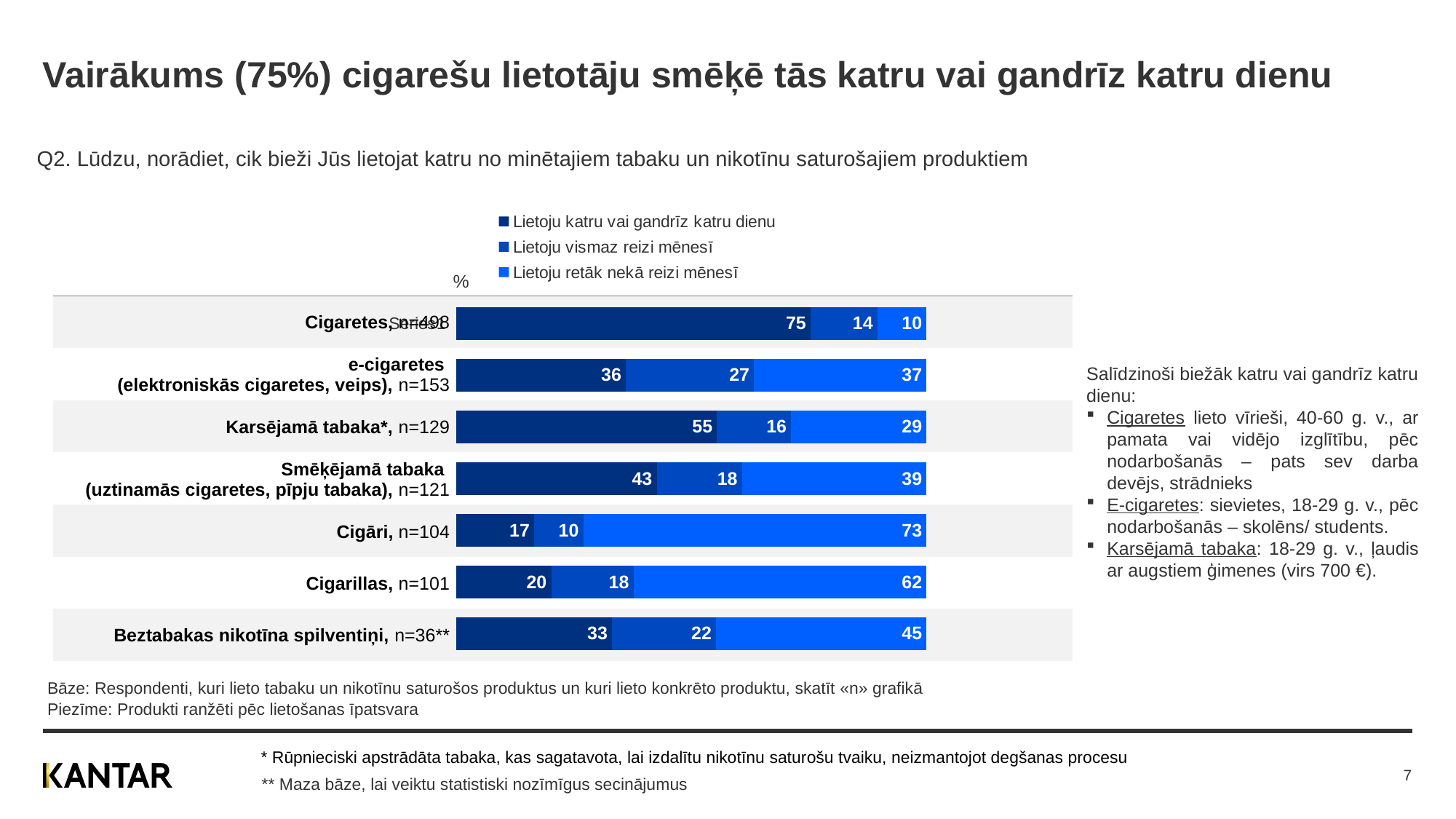
What is the total of the three segments for the Cigaretes bar? 99 What is the sample size (n) shown for Cigarillas? n=101 Which product has the highest share of users who use it every day or almost every day? Cigaretes What is the value for Cigāri in the 'Lietoju retāk nekā reizi mēnesī' series? 73 What is the difference between the daily-use values for Karsējamā tabaka and Smēķējamā tabaka? 12 Which is larger: the 'Lietoju retāk nekā reizi mēnesī' value for Cigarillas or for Beztabakas nikotīna spilventiņi? Cigarillas Which product has the lowest share of users who use it every day or almost every day? Cigāri What type of chart is shown on the slide? Stacked bar chart How many series does the legend list? 3 What percentage of cigarette (Cigaretes) users say they use them every day or almost every day (Lietoju katru vai gandrīz katru dienu)? 75 What is the value for e-cigaretes in the 'Lietoju vismaz reizi mēnesī' series? 27 How many product categories are shown in the chart? 7